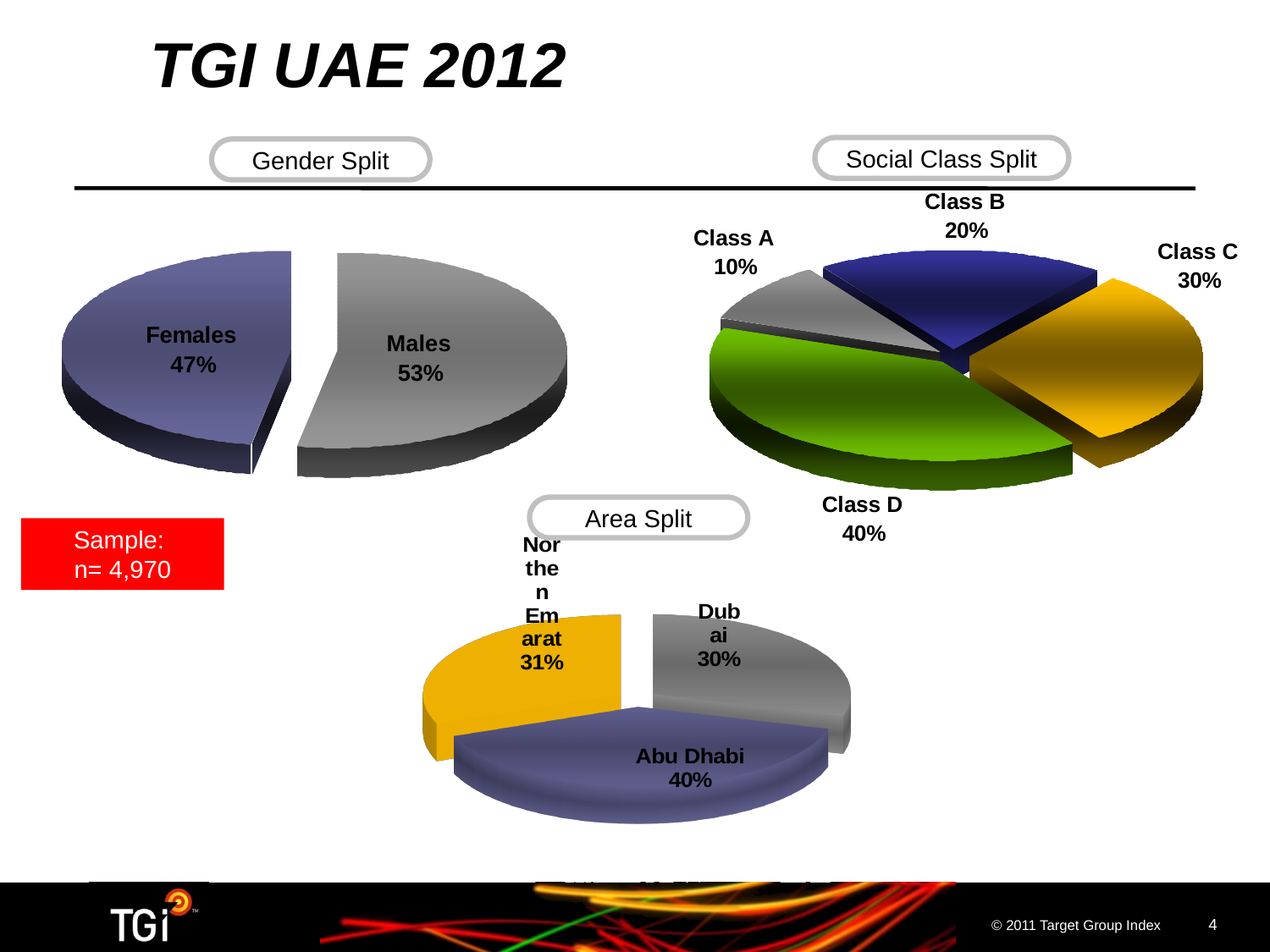
What type of chart is the Gender Split chart? Pie chart In the Area Split chart, which area has the largest share? Abu Dhabi In the Area Split chart, what percentage is Abu Dhabi? 40% In the Social Class Split chart, which class has the largest share? Class D In the Gender Split chart, what is the difference between the Males and Females percentages? 6% In the Gender Split chart, what percentage is Males? 53% In the Gender Split chart, what percentage is Females? 47% In the Social Class Split chart, how many classes are shown? 4 In the Gender Split chart, which is larger, Males or Females? Males In the Social Class Split chart, which class has the smallest share? Class A In the Social Class Split chart, what percentage is Class C? 30% In the Social Class Split chart, what is the difference between Class D and Class B? 20%